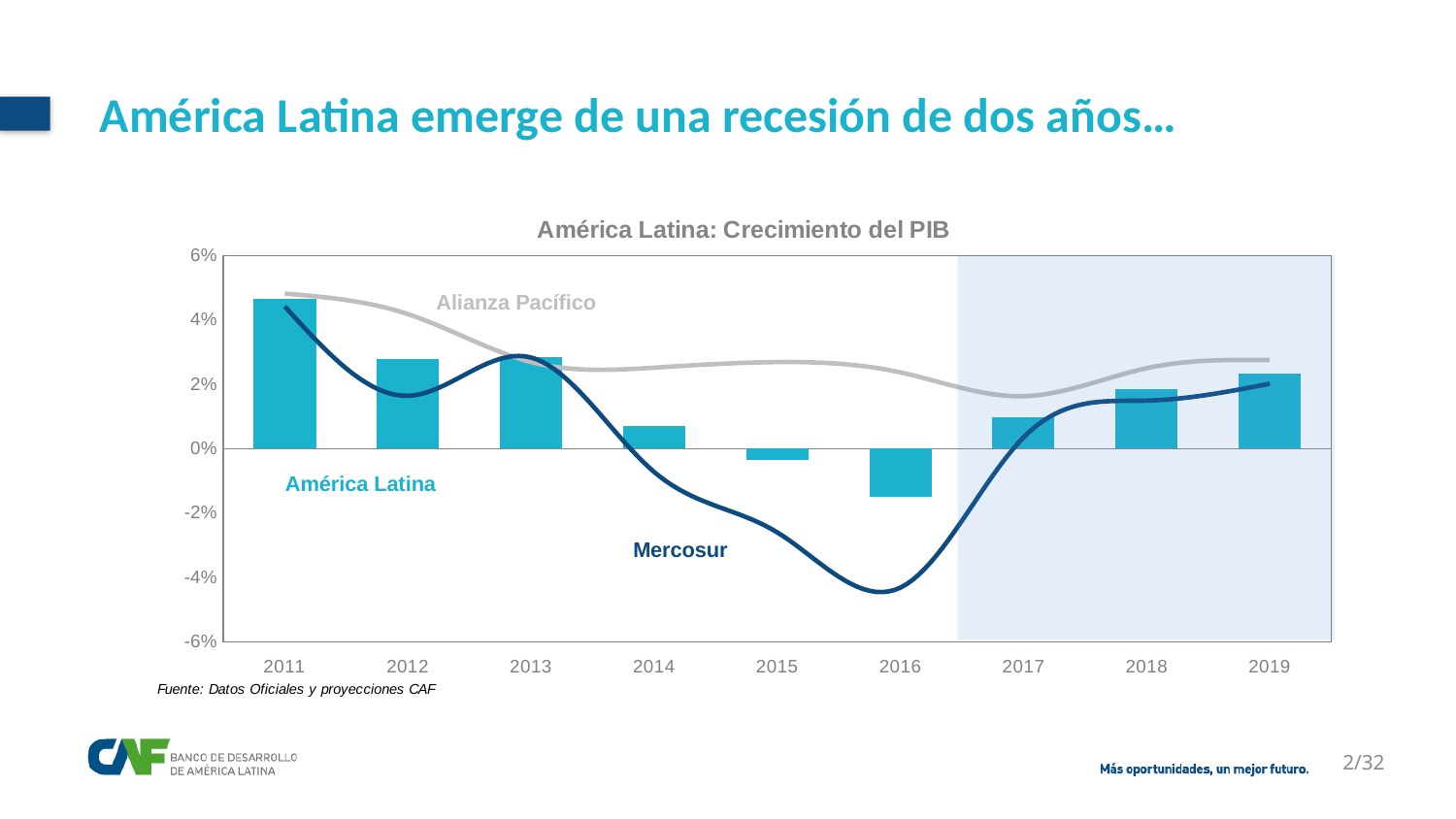
In which year is the América Latina bar the lowest? 2016 How many series are plotted in the chart? 3 Do the América Latina bars rise or fall from 2016 to 2019? rise Is the América Latina value for 2016 greater or less than 0%? less What is the title of the chart? América Latina: Crecimiento del PIB Which series is higher in 2016, Alianza Pacífico or Mercosur? Alianza Pacífico How many years are shown on the x axis of the chart? 9 Is the América Latina value for 2011 greater or less than 4%? greater Is the Mercosur value for 2016 greater or less than -4%? less What kind of chart is shown on the slide? Bar and line chart Which is larger, the América Latina bar for 2018 or for 2019? 2019 In which year is the América Latina bar the highest? 2011